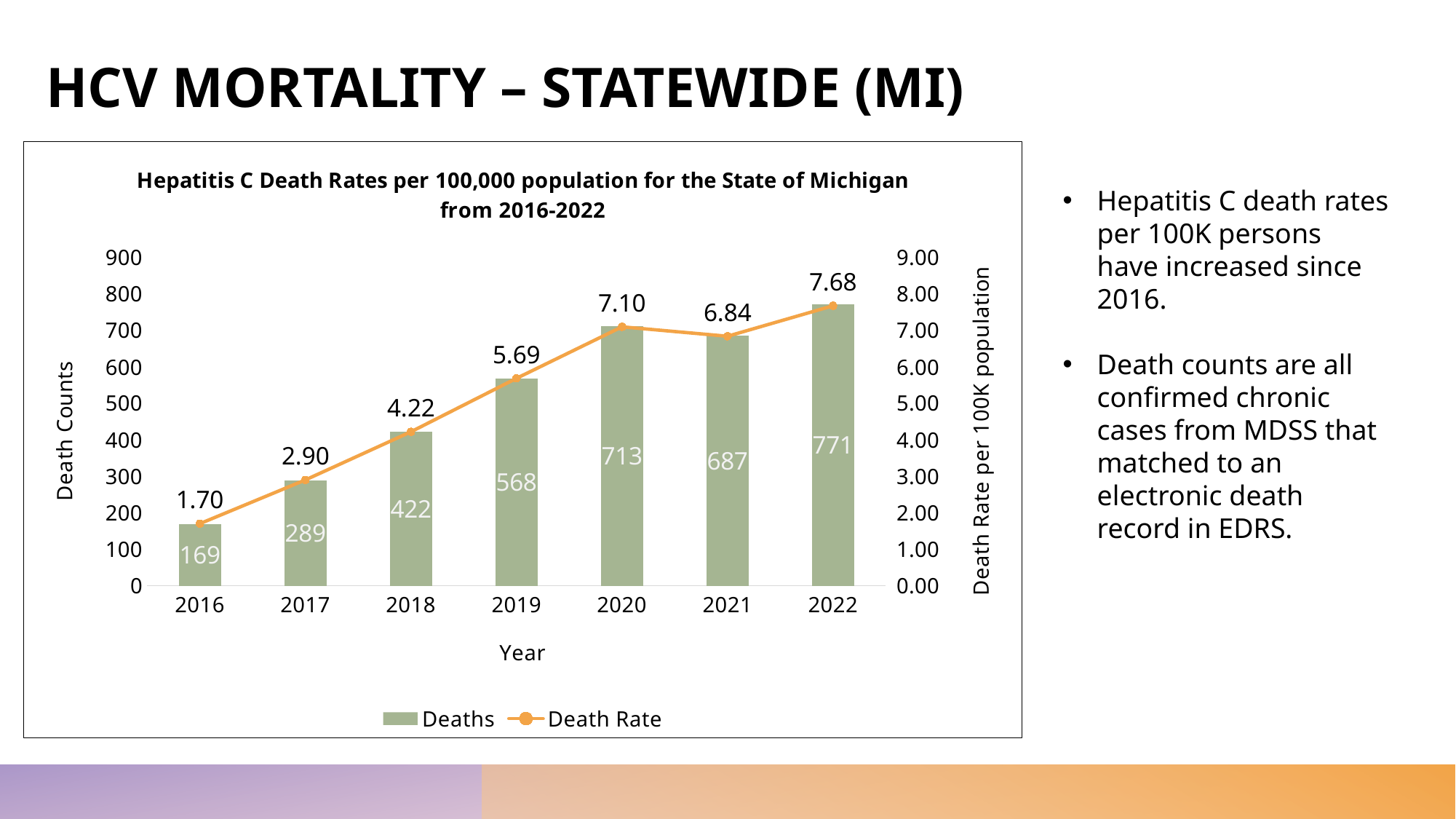
Which year has the lowest death rate? 2016 Does the death rate generally rise or fall from 2016 to 2022? Rise How many years are shown on the x axis? 7 What is the label of the right-hand vertical axis? Death Rate per 100K population How many deaths are shown for 2019? 568 What is the difference in deaths between 2020 and 2021? 26 What is the death rate per 100K population for 2021? 6.84 Which year has the highest number of deaths? 2022 Which year has more deaths, 2018 or 2019? 2019 What kind of chart is used to show the Deaths series? Bar chart How many series does the legend list? 2 Is the death rate for 2020 greater or less than 7.00? greater